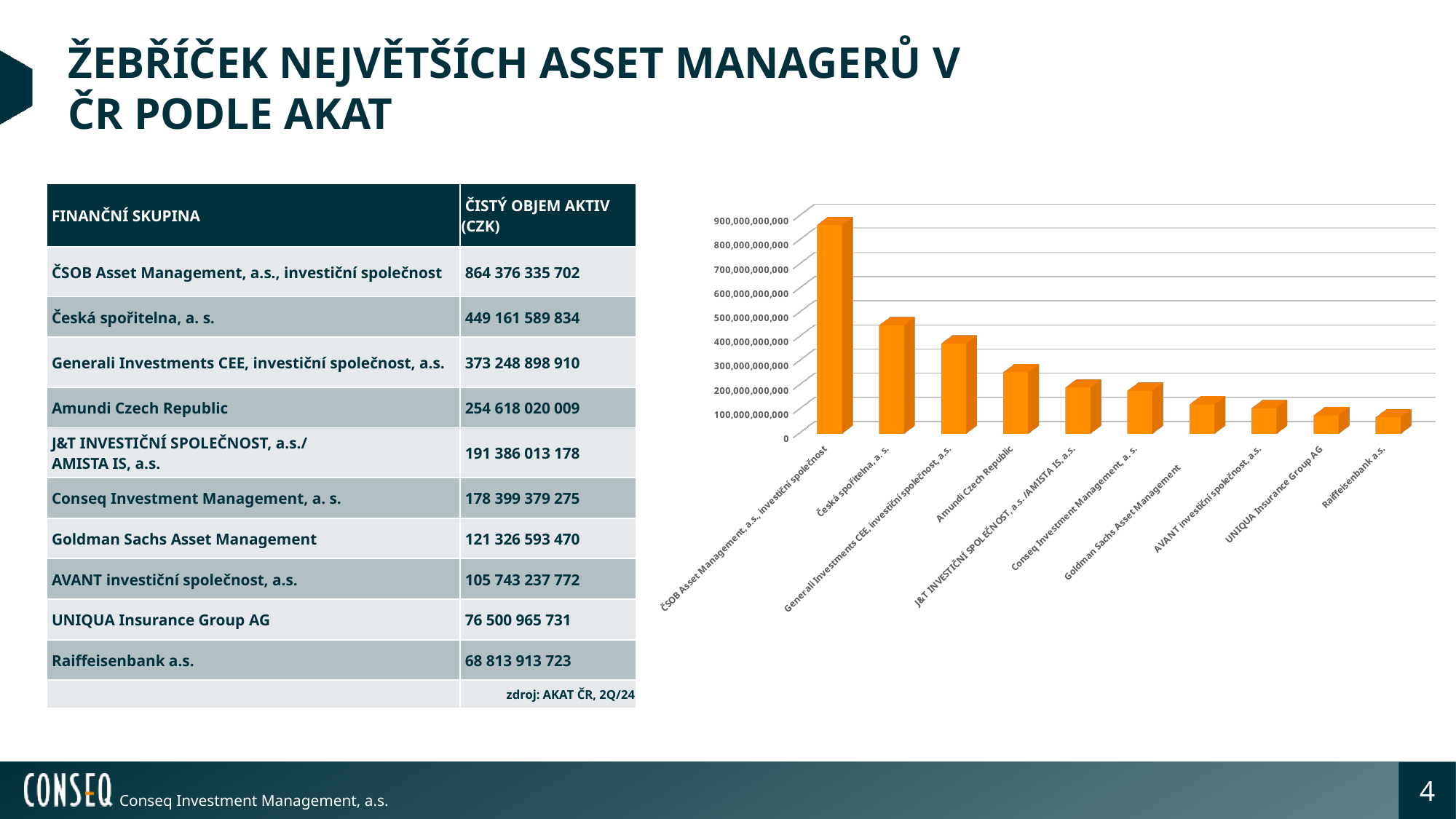
Which financial group has the lowest net asset volume in the chart? Raiffeisenbank a.s. What is the net asset volume (CZK) for Česká spořitelna, a. s.? 449 161 589 834 Do the bar values rise or fall from left to right along the x axis? fall Is the bar for Amundi Czech Republic greater or less than 200,000,000,000? greater Which financial group has the highest net asset volume in the chart? ČSOB Asset Management, a.s., investiční společnost What kind of chart is shown on the slide? bar chart Which has a larger net asset volume, Generali Investments CEE or Amundi Czech Republic? Generali Investments CEE, investiční společnost, a.s. What is the net asset volume (CZK) for Conseq Investment Management, a. s.? 178 399 379 275 Is the bar for Goldman Sachs Asset Management greater or less than 200,000,000,000? less What is the net asset volume (CZK) for Raiffeisenbank a.s.? 68 813 913 723 How many bars (financial groups) does the chart show? 10 What is the difference in net asset volume (CZK) between ČSOB Asset Management and Česká spořitelna? 415 214 745 868